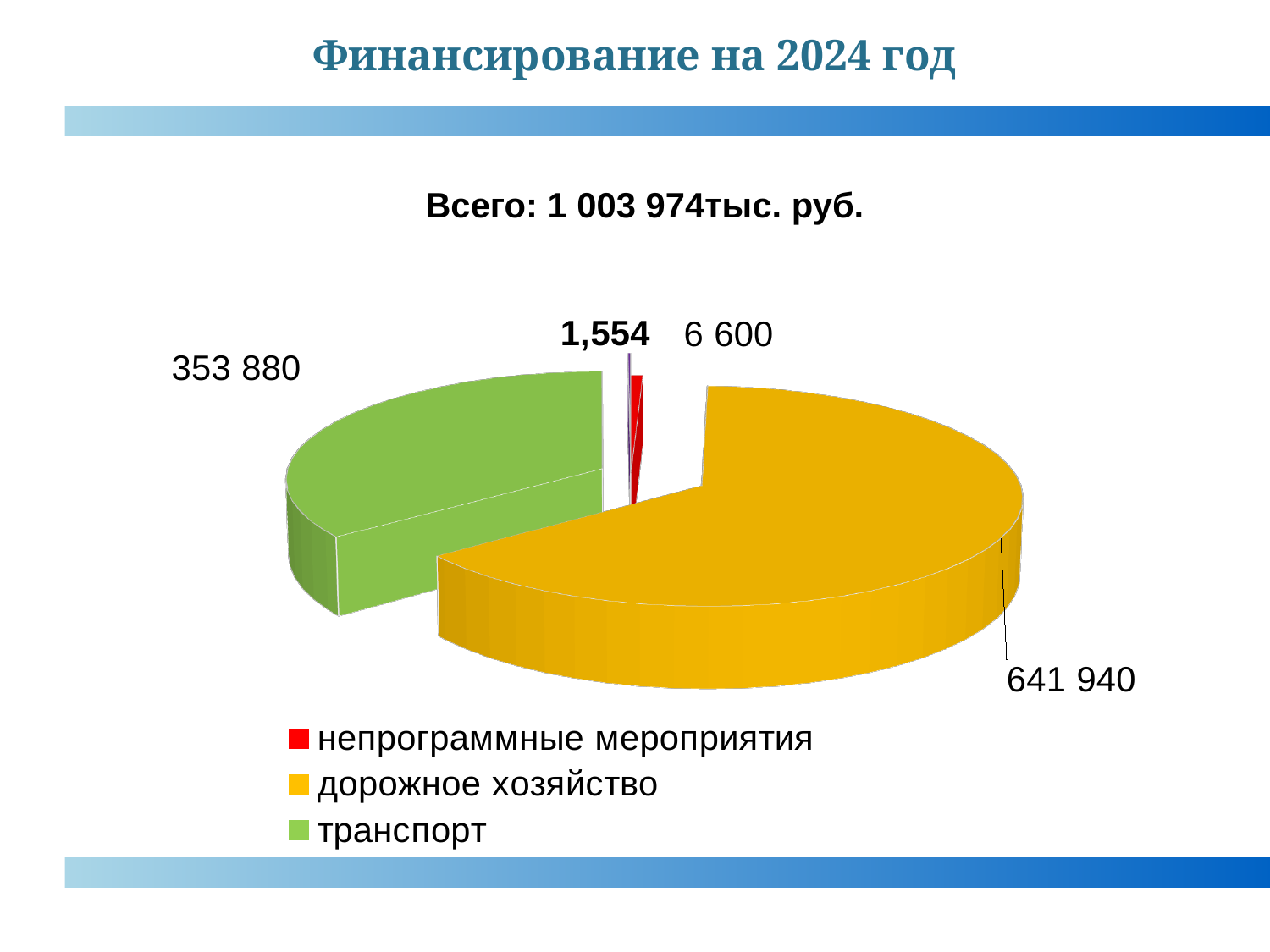
What is the value for транспорт? 353 880 What is the value for дорожное хозяйство? 641 940 Which category has the largest slice of the pie? дорожное хозяйство How many entries does the legend list? 3 Which colour represents транспорт in the chart? green What is the difference between the values for дорожное хозяйство and транспорт? 288 060 Which is larger, дорожное хозяйство or транспорт? дорожное хозяйство What kind of chart is shown on the slide? pie chart What total is stated above the chart? 1 003 974тыс. руб.